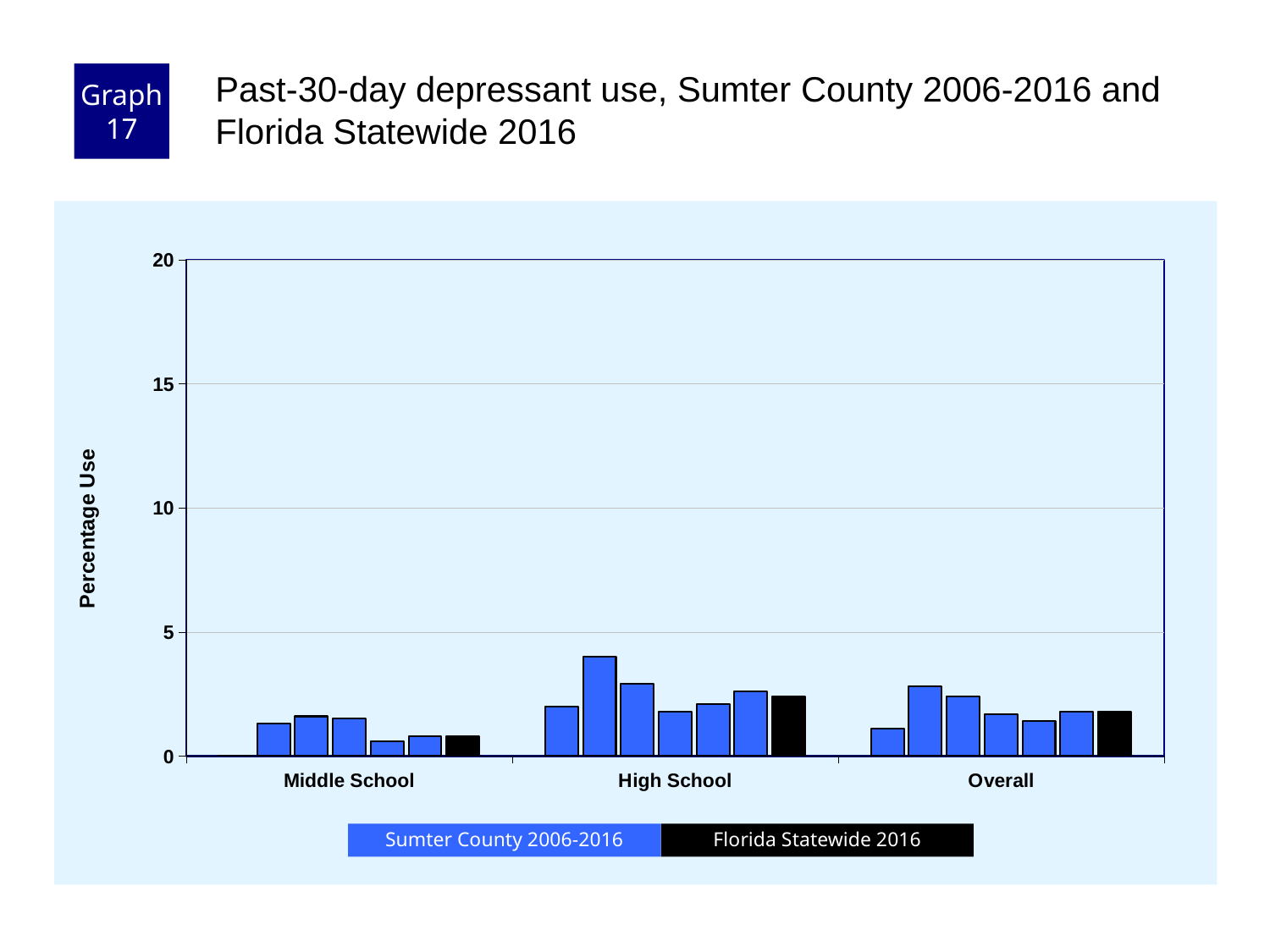
Which category contains the tallest bar in the chart? High School Is the Florida Statewide 2016 value for High School greater or less than 5? less Which series is shown in black in the legend? Florida Statewide 2016 Is the tallest Sumter County 2006-2016 bar for High School greater or less than 5? less How many series does the legend list? 2 Is the Florida Statewide 2016 value for Middle School greater or less than 5? less What kind of chart is shown on the slide? bar chart How many school-level categories are shown on the x axis? 3 Which is larger, the Florida Statewide 2016 value for Overall or for Middle School? Overall What is the label on the y axis? Percentage Use Which is larger, the Florida Statewide 2016 value for High School or for Middle School? High School